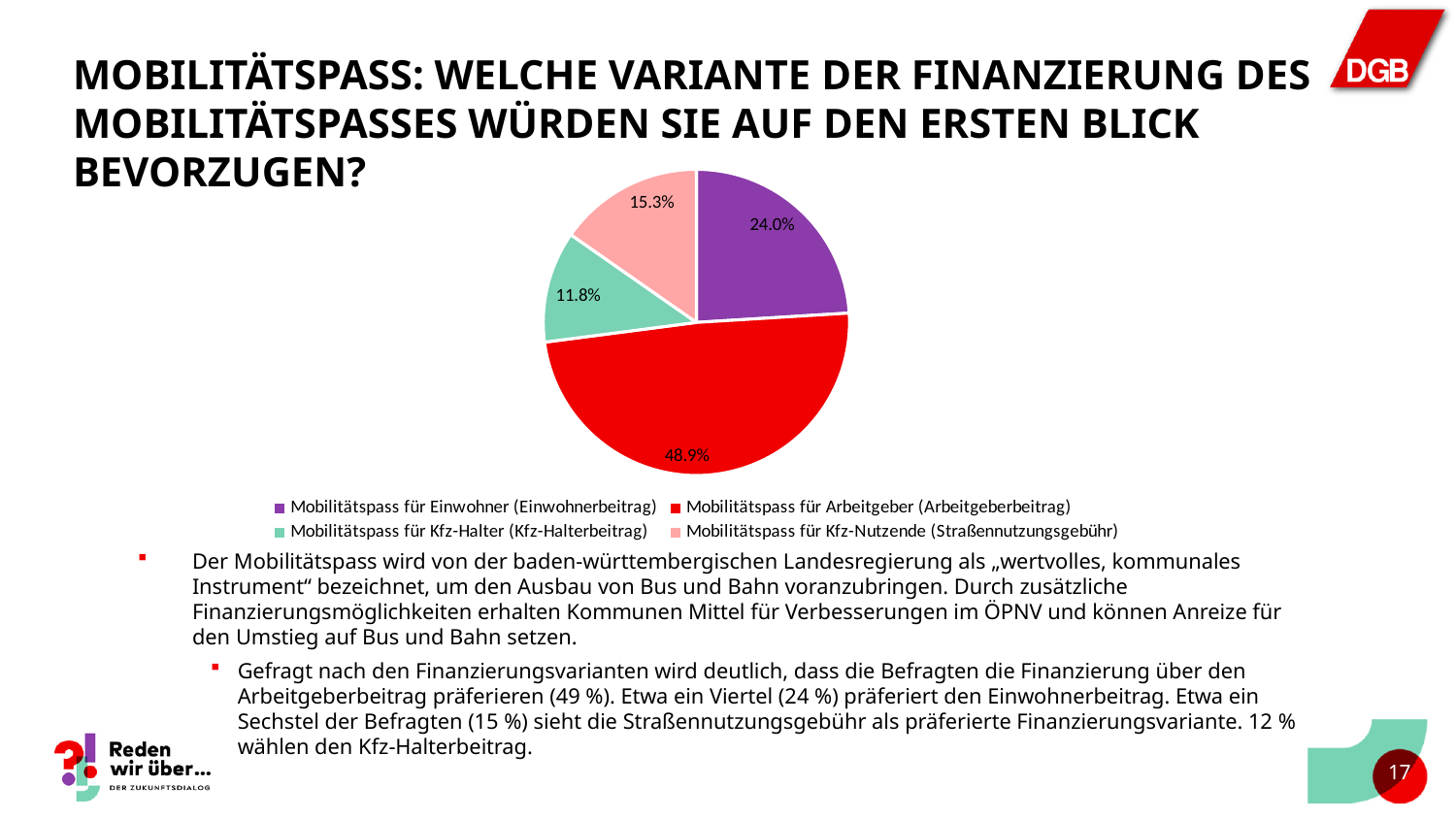
What share of the pie does Mobilitätspass für Kfz-Halter (Kfz-Halterbeitrag) have? 11.8% What share of the pie does Mobilitätspass für Arbeitgeber (Arbeitgeberbeitrag) have? 48.9% What share of the pie does Mobilitätspass für Einwohner (Einwohnerbeitrag) have? 24.0% What is the difference in percentage points between the Arbeitgeberbeitrag slice and the Einwohnerbeitrag slice? 24.9 percentage points Which financing variant has the largest share of the pie? Mobilitätspass für Arbeitgeber (Arbeitgeberbeitrag) What share of the pie does Mobilitätspass für Kfz-Nutzende (Straßennutzungsgebühr) have? 15.3% Which financing variant has the smallest share of the pie? Mobilitätspass für Kfz-Halter (Kfz-Halterbeitrag) Which slice is larger: Kfz-Nutzende (Straßennutzungsgebühr) or Kfz-Halter (Kfz-Halterbeitrag)? Kfz-Nutzende (Straßennutzungsgebühr) How many slices does the pie chart have? 4 What colour is the slice for Mobilitätspass für Arbeitgeber (Arbeitgeberbeitrag)? Red What kind of chart is shown on the slide? Pie chart How many entries does the legend list? 4